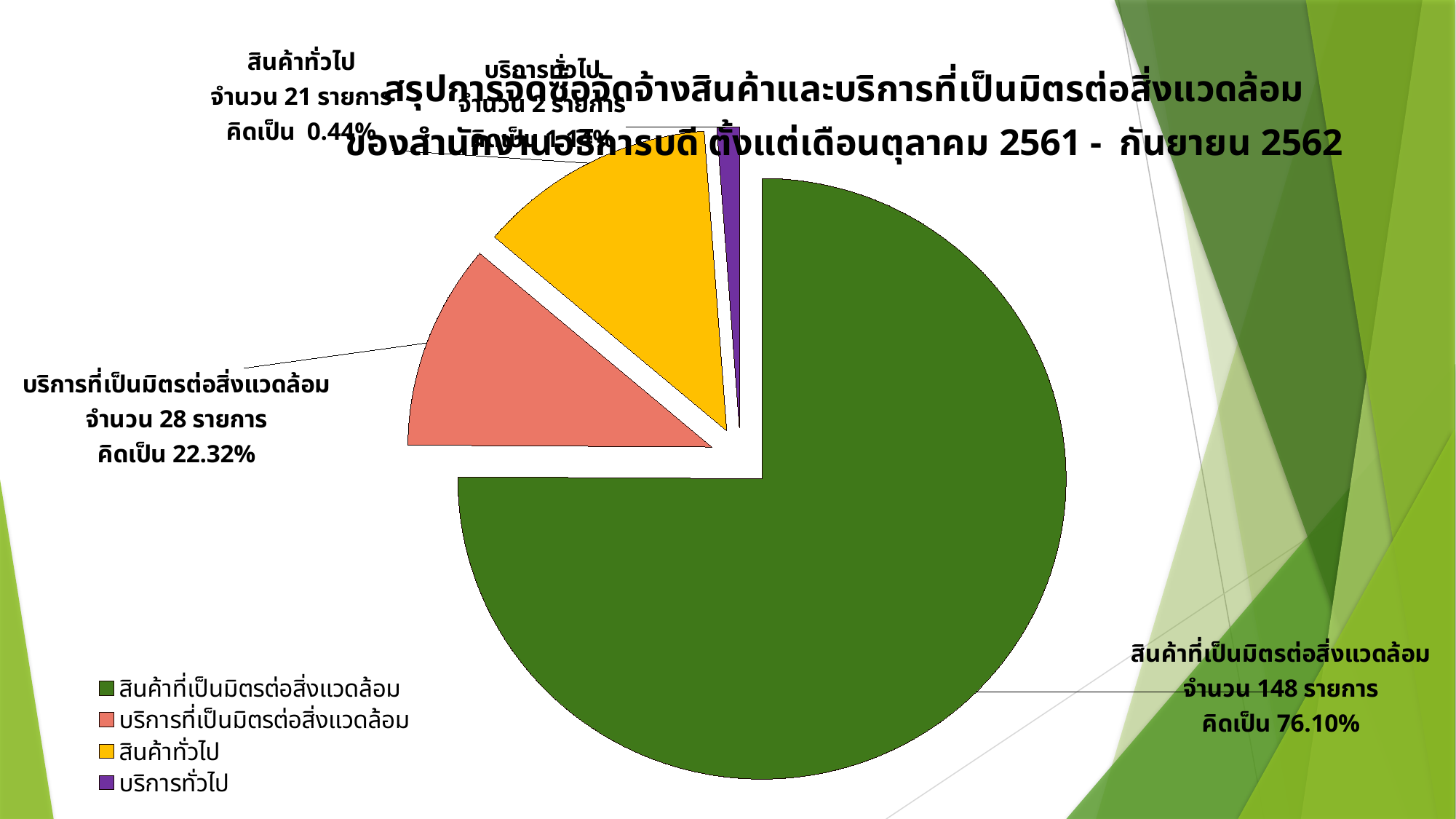
How many items (รายการ) are shown for สินค้าทั่วไป? 21 รายการ What is the difference in number of items between สินค้าที่เป็นมิตรต่อสิ่งแวดล้อม and บริการที่เป็นมิตรต่อสิ่งแวดล้อม? 120 รายการ How many items (รายการ) are shown for บริการที่เป็นมิตรต่อสิ่งแวดล้อม? 28 รายการ Which category has the largest slice of the pie? สินค้าที่เป็นมิตรต่อสิ่งแวดล้อม How many items (รายการ) are shown for สินค้าที่เป็นมิตรต่อสิ่งแวดล้อม? 148 รายการ What percentage share is shown for สินค้าที่เป็นมิตรต่อสิ่งแวดล้อม? 76.10% Which colour represents สินค้าทั่วไป in the pie chart? yellow What kind of chart is shown on the slide? pie chart What percentage share is shown for บริการที่เป็นมิตรต่อสิ่งแวดล้อม? 22.32% How many categories (slices) does the pie chart have? 4 How many entries does the legend list? 4 Which category has the smallest slice of the pie? บริการทั่วไป